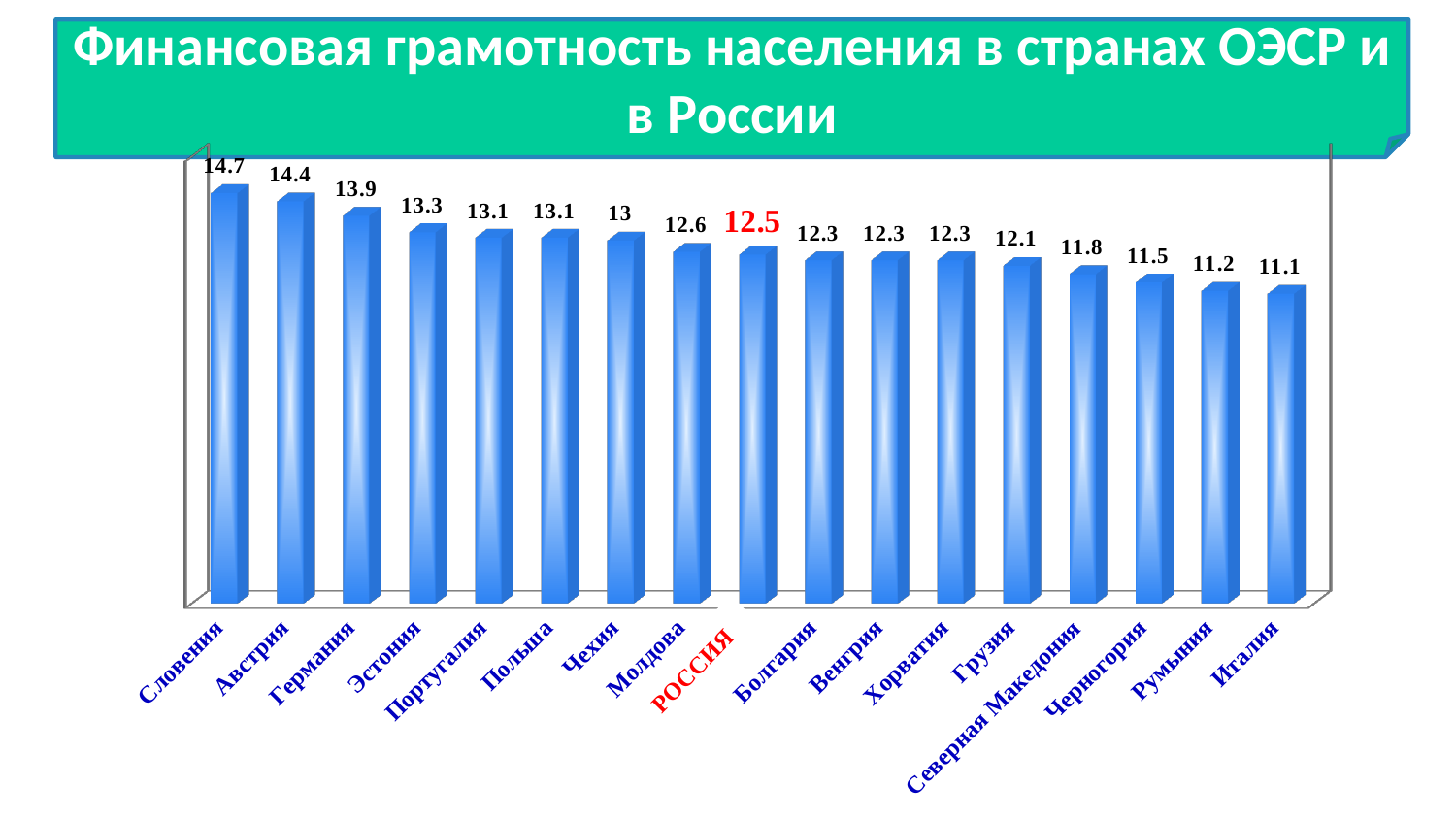
Do the values rise or fall from left to right along the x axis? Fall Which has a larger value, Германия or Молдова? Германия What kind of chart is shown on the slide? Bar chart Which country has the lowest value on the chart? Италия What is the value shown for Словения? 14.7 What is the value shown for РОССИЯ? 12.5 Which country has the highest value on the chart? Словения How many countries are shown on the chart? 17 What is the value shown for Чехия? 13 What is the difference between the values for Австрия and Италия? 3.3 What is the difference between the values for Словения and РОССИЯ? 2.2 What is the value shown for Северная Македония? 11.8